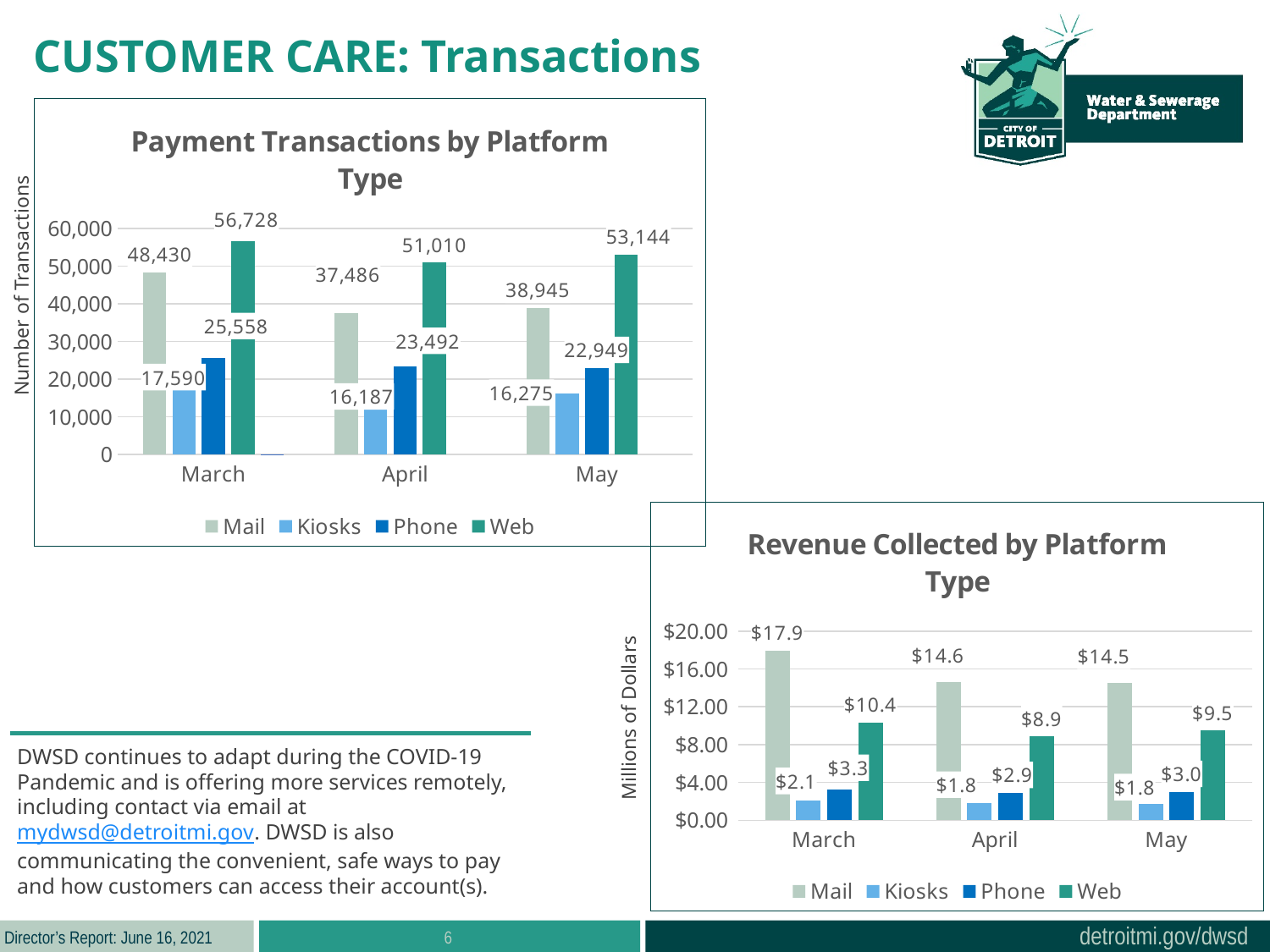
In the Payment Transactions by Platform Type chart, which platform had the most transactions in April? Web In the Revenue Collected by Platform Type chart, is the Web revenue for April greater or less than $8.00? greater In the Revenue Collected by Platform Type chart, does Mail revenue rise or fall from March to May? Fall How many months are shown on the x axis of the Payment Transactions by Platform Type chart? 3 In the Payment Transactions by Platform Type chart, how many transactions were made via Web in March? 56,728 In the Payment Transactions by Platform Type chart, were there more Phone transactions in March or in April? March What kind of chart is the Payment Transactions by Platform Type chart? Bar chart How many series does the legend of the Revenue Collected by Platform Type chart list? 4 In the Revenue Collected by Platform Type chart, how much revenue was collected by Mail in March? $17.9 In the Revenue Collected by Platform Type chart, which platform collected the least revenue in May? Kiosks In the Revenue Collected by Platform Type chart, by how much did Mail revenue decrease from March to April? $3.3 In the Payment Transactions by Platform Type chart, how many more transactions were made via Web than via Mail in March? 8,298